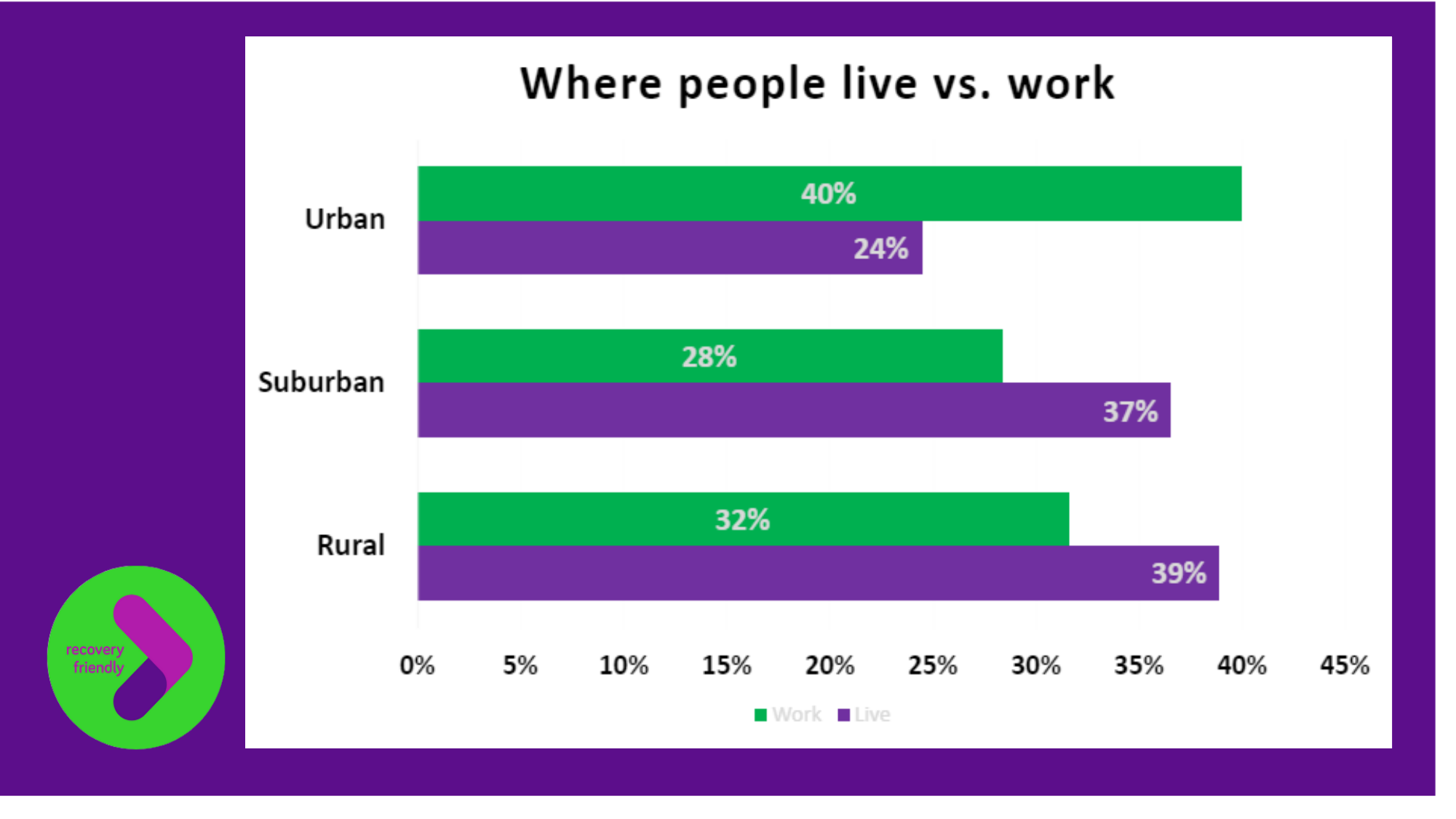
What is the Work value for Urban? 40% Which category has the highest Work value? Urban Which is larger for Rural, the Work value or the Live value? Live How many series does the legend list? 2 What is the difference between the Live and Work values for Suburban? 9% What is the Live value for Suburban? 37% What is the title of the chart? Where people live vs. work Which category has the lowest Live value? Urban What is the difference between the Work and Live values for Urban? 16% What kind of chart is shown on the slide? Bar chart How many categories are shown on the chart? 3 What is the Live value for Rural? 39%